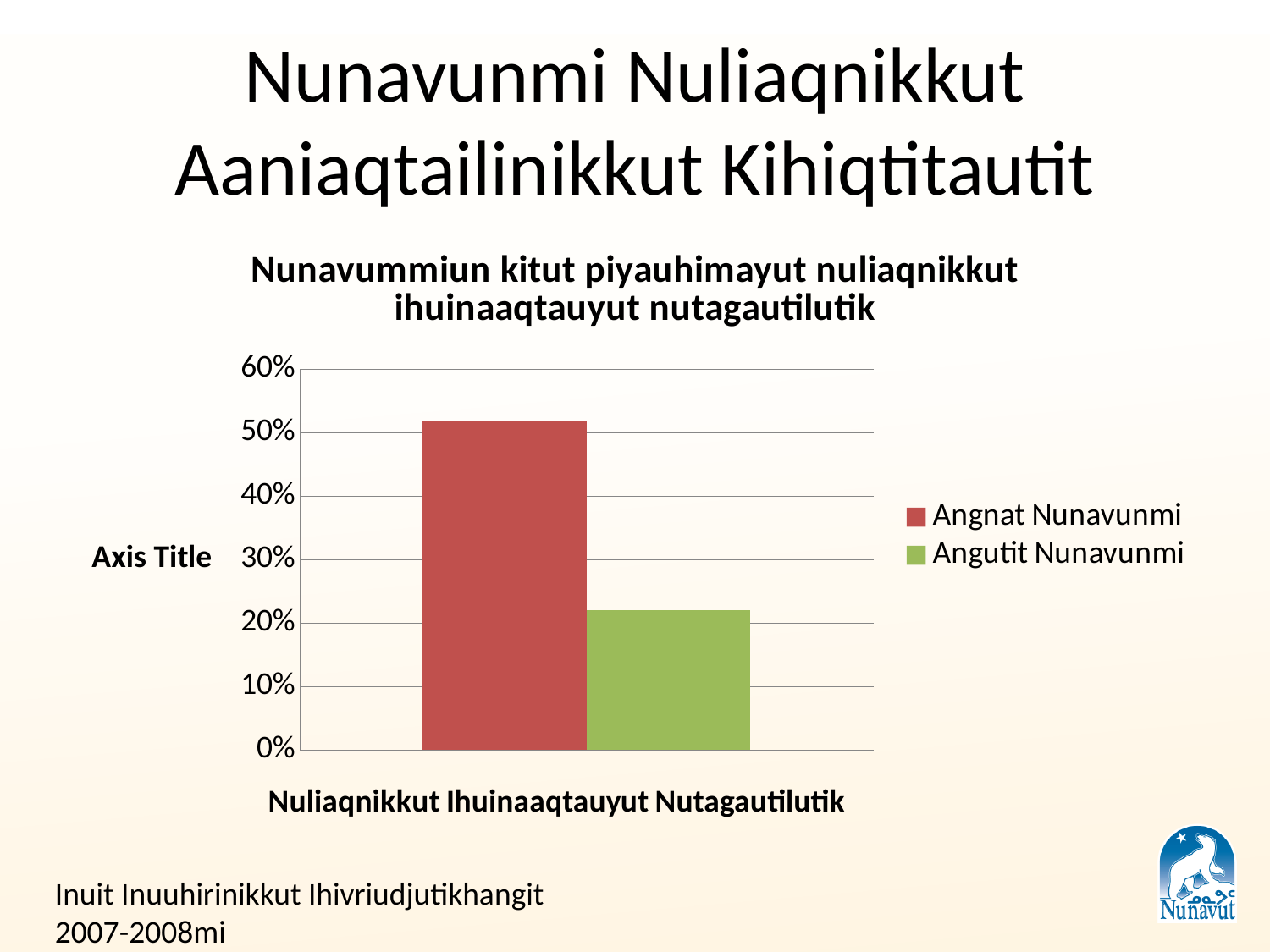
Which series has the lower value in the chart? Angutit Nunavunmi Which series has the higher value in the chart? Angnat Nunavunmi How many categories are shown on the x axis of the chart? 1 Is the value for Angutit Nunavunmi greater or less than 10%? greater Which is larger, the value for Angnat Nunavunmi or the value for Angutit Nunavunmi? Angnat Nunavunmi What is the title of the chart? Nunavummiun kitut piyauhimayut nuliaqnikkut ihuinaaqtauyut nutagautilutik Is the value for Angnat Nunavunmi greater or less than 40%? greater How many series does the chart's legend list? 2 Is the value for Angutit Nunavunmi greater or less than 30%? less What kind of chart is shown on the slide? bar chart What colour are the bars for the Angutit Nunavunmi series? green